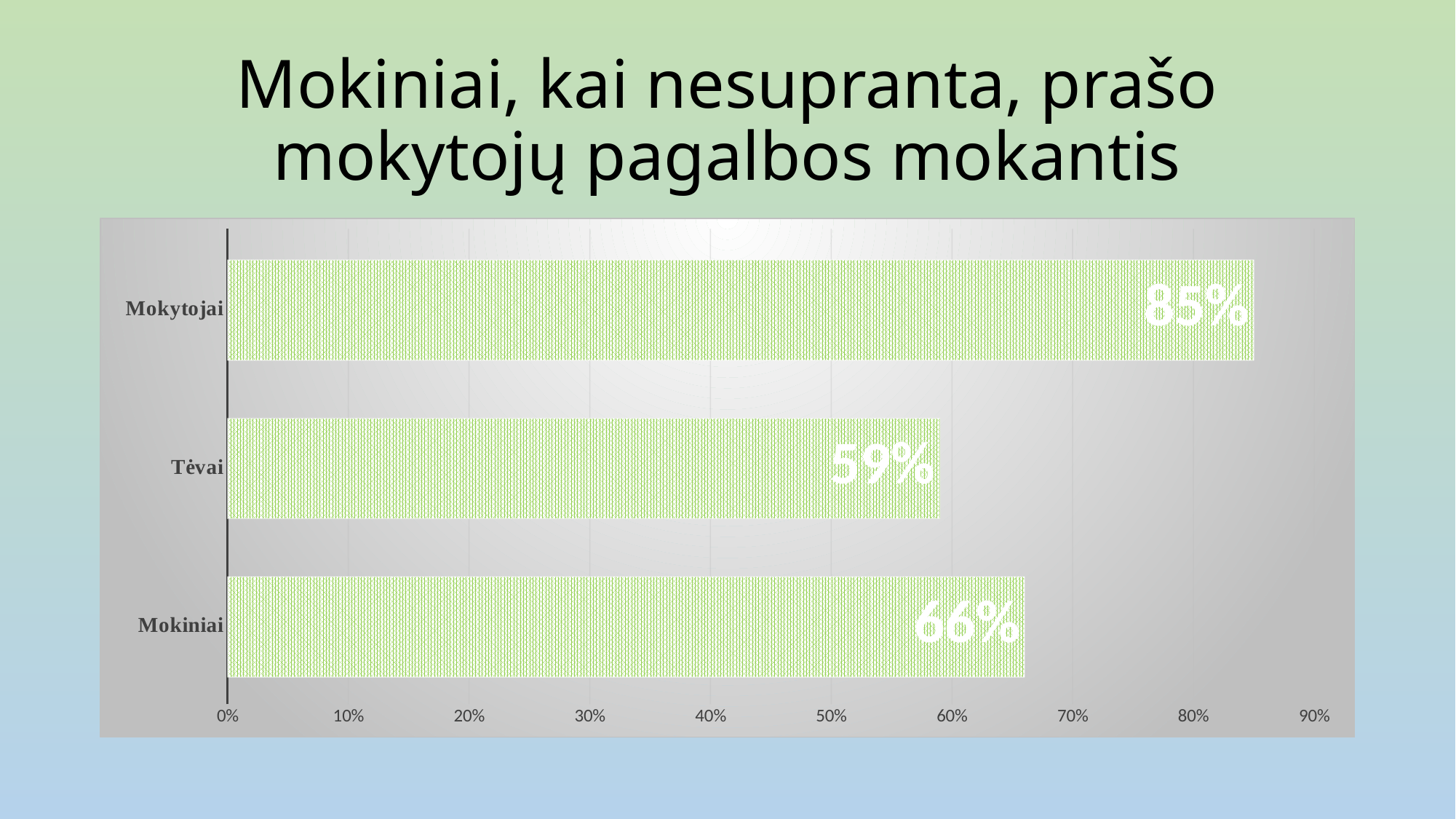
What is the difference between the values for Mokytojai and Tėvai? 26% What is the value for Mokiniai? 66% What is the value for Tėvai? 59% Which category has the highest value? Mokytojai What is the title of the slide? Mokiniai, kai nesupranta, prašo mokytojų pagalbos mokantis Which category has the lowest value? Tėvai What is the difference between the values for Mokiniai and Tėvai? 7% What kind of chart is shown on the slide? bar chart How many categories are shown in the chart? 3 Which is larger, the value for Mokiniai or the value for Tėvai? Mokiniai What is the value for Mokytojai? 85% Is the value for Mokytojai greater or less than 80%? greater